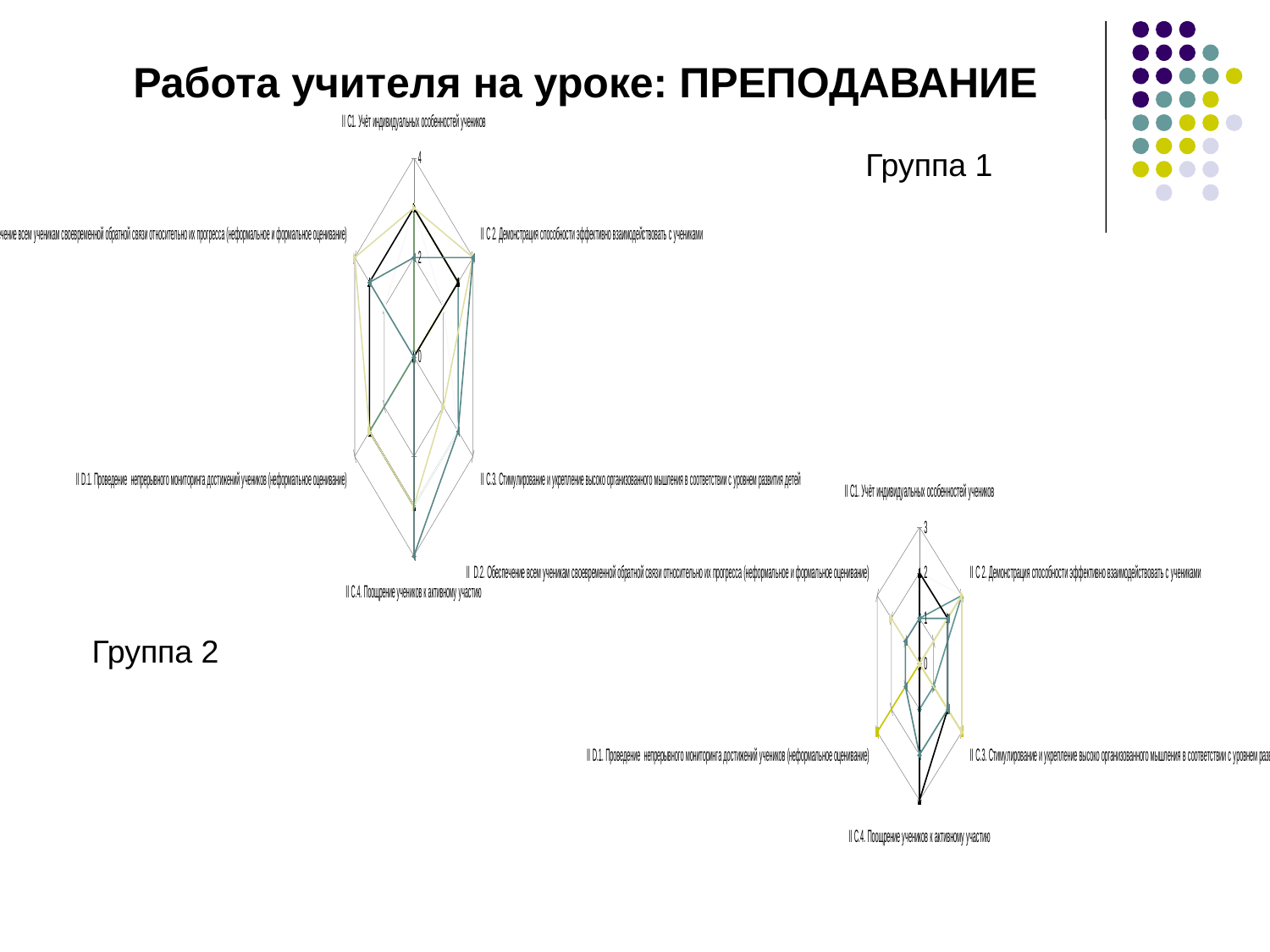
How many category axes does the larger radar chart at the top left have? 6 How many data series (lines) are plotted on the larger radar chart at the top left? 6 What kind of chart is the larger chart at the top left of the slide? radar chart On the smaller radar chart at the bottom right, is the value of the black series for II C.4 (Поощрение учеников к активному участию) greater or less than 2? greater On the smaller radar chart at the bottom right, is the value of the teal series for II C1 (Учёт индивидуальных особенностей учеников) greater or less than 2? less What is the highest tick value shown on the axis of the smaller radar chart at the bottom right? 3 How many data series (lines) are plotted on the smaller radar chart at the bottom right? 6 How many category axes does the smaller radar chart at the bottom right have? 6 On the larger radar chart at the top left, is the value of the teal series for II C.4 (Поощрение учеников к активному участию) greater or less than 2? greater What kind of chart is the smaller chart at the bottom right of the slide? radar chart What is the highest tick value shown on the axis of the larger radar chart at the top left? 4